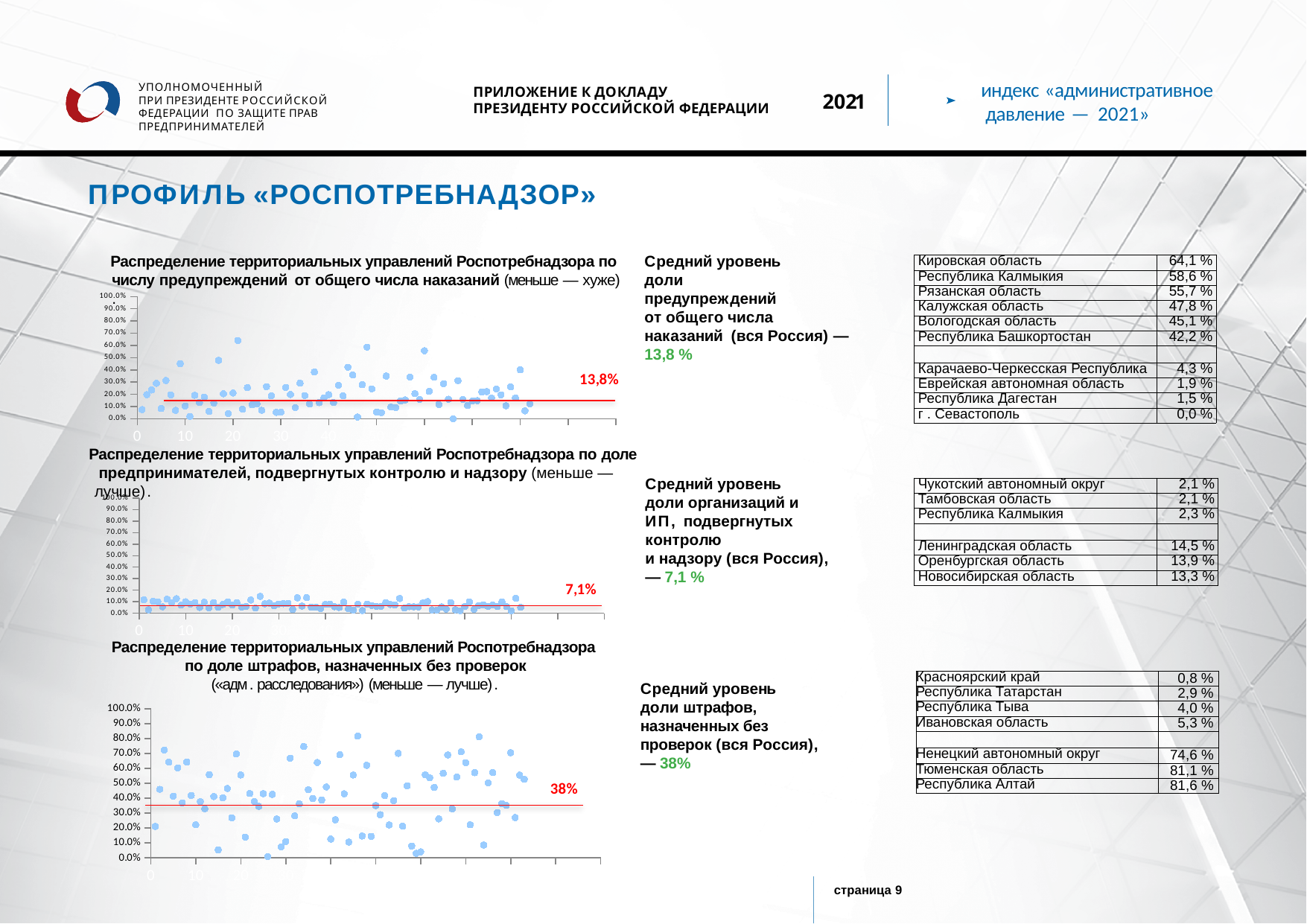
What is the difference between the average line values of the bottom chart (38%) and the top chart (13,8%)? 24,2% On the top chart, are most of the points above or below the 13,8% line? above On the bottom chart (distribution by share of fines imposed without inspections), what value is marked by the horizontal line? 38% Which of the three charts has the highest average line value: the top, middle or bottom chart? bottom chart On the top chart (distribution by share of warnings), what value is marked by the red horizontal line? 13,8% Is the average line on the middle chart greater or less than 10.0% on the y axis? less What colour are the data points in the three scatter charts? light blue On the middle chart (distribution by share of entrepreneurs subjected to control and supervision), what value is marked by the red horizontal line? 7,1% What is the maximum value shown on the y axis of the bottom chart? 100.0% Which of the three charts has the lowest average line value: the top, middle or bottom chart? middle chart Is the average line on the bottom chart greater or less than 30.0% on the y axis? greater What kind of chart is the top chart on the slide? scatter chart